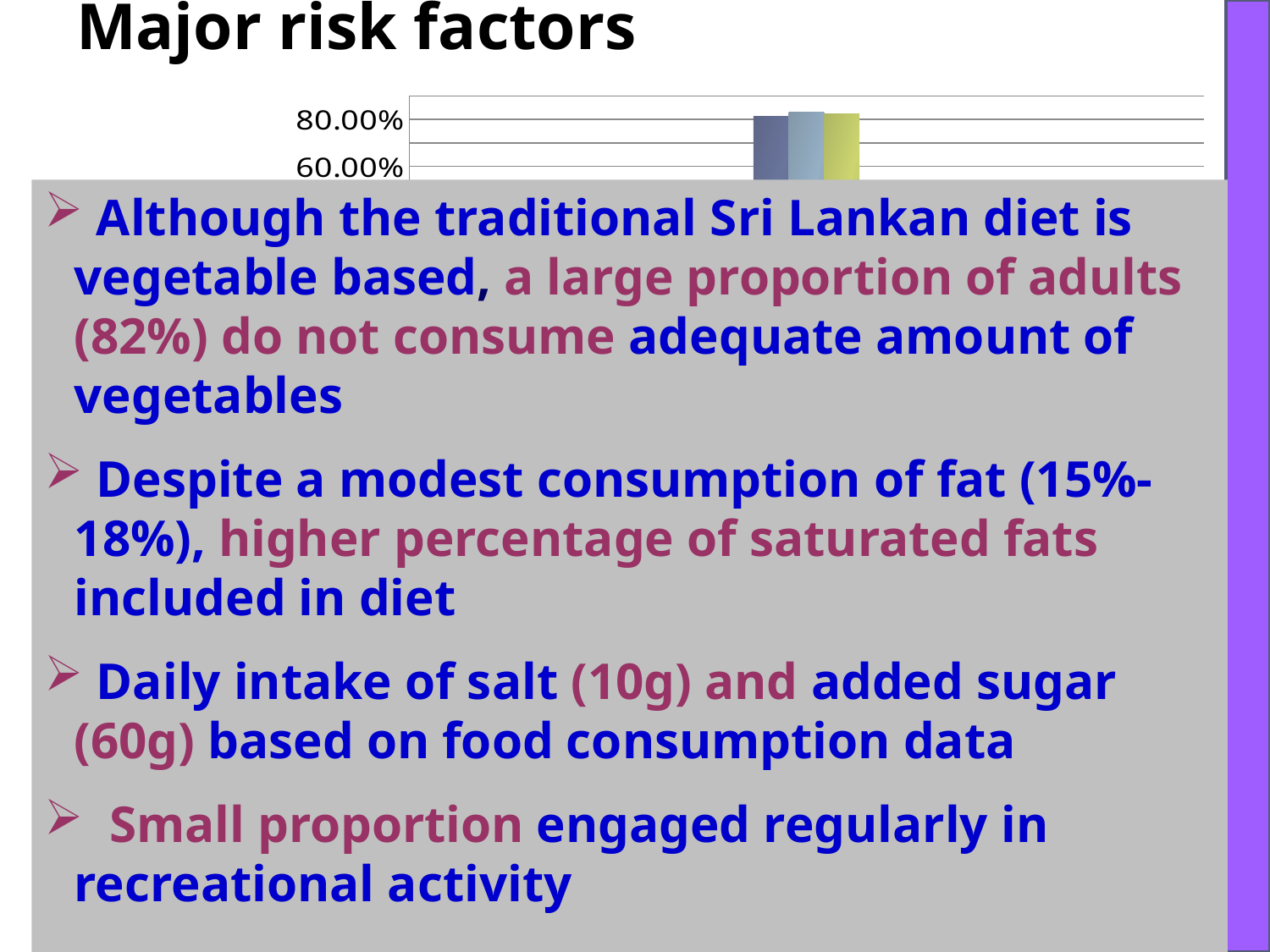
What kind of chart is partially visible at the top of the slide? bar chart How many bars are visible rising above the 60.00% gridline in the chart? 3 What colour is the rightmost visible bar in the chart? yellow Is the value of the yellow bar in the chart greater or less than 60.00%? greater Is the value of the leftmost (blue-gray) bar in the chart greater or less than 60.00%? greater Which two y-axis tick labels are readable on the chart? 80.00% and 60.00%